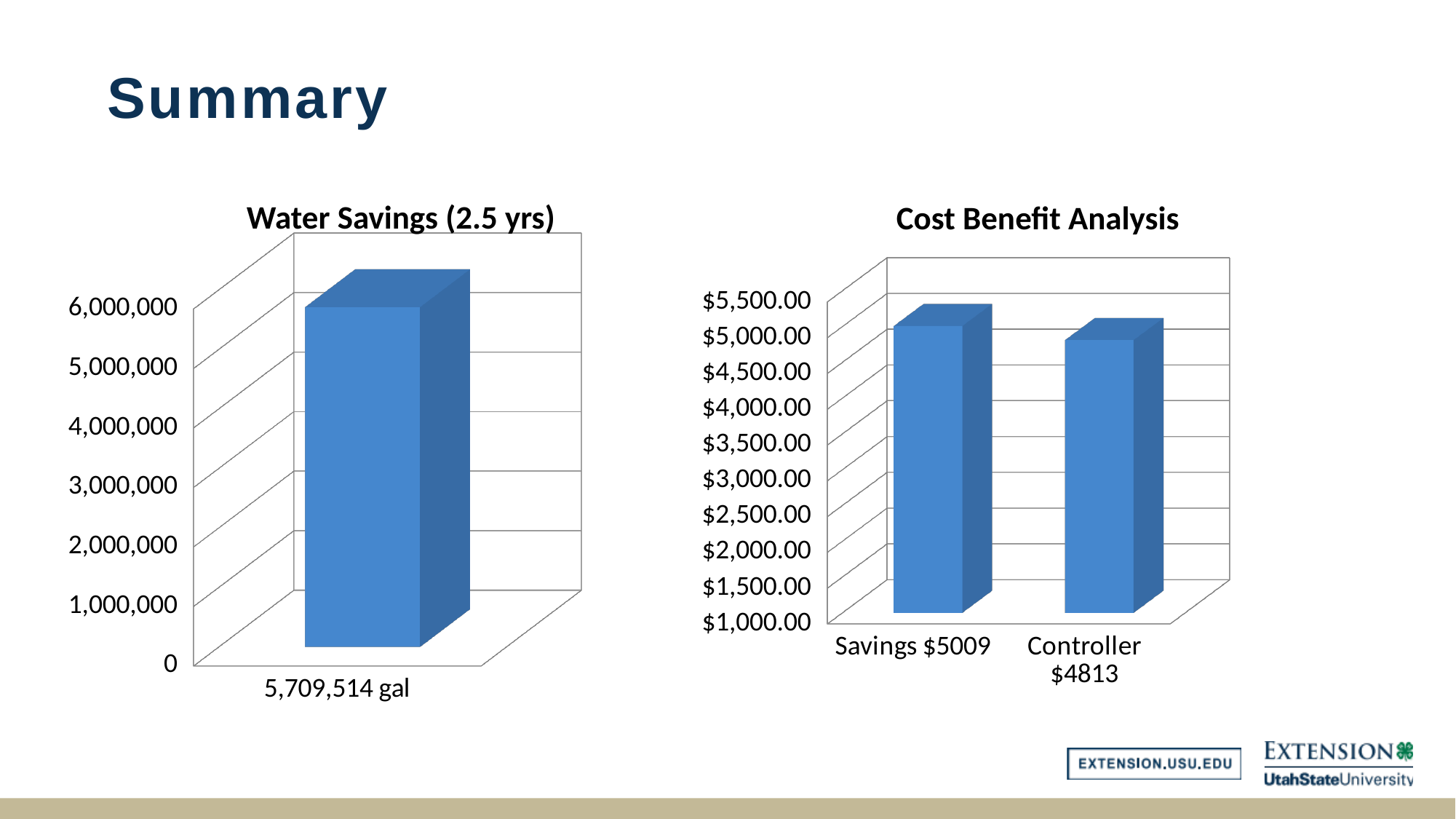
How many categories are shown in the Cost Benefit Analysis chart? 2 What kind of chart is the Cost Benefit Analysis chart? bar chart In the Water Savings (2.5 yrs) chart, is the value of the bar greater or less than 5,000,000? greater How many bars are plotted in the Water Savings (2.5 yrs) chart? 1 In the Cost Benefit Analysis chart, is the value for Controller greater or less than $5,000.00? less In the Cost Benefit Analysis chart, what value is printed for Controller? $4813 In the Water Savings (2.5 yrs) chart, what value is printed as the bar's label? 5,709,514 gal In the Cost Benefit Analysis chart, what is the difference between the Savings value and the Controller value? $196 In the Cost Benefit Analysis chart, which category has the lower value? Controller In the Cost Benefit Analysis chart, which category has the higher value? Savings What kind of chart is the Water Savings (2.5 yrs) chart? bar chart In the Cost Benefit Analysis chart, what value is printed for Savings? $5009